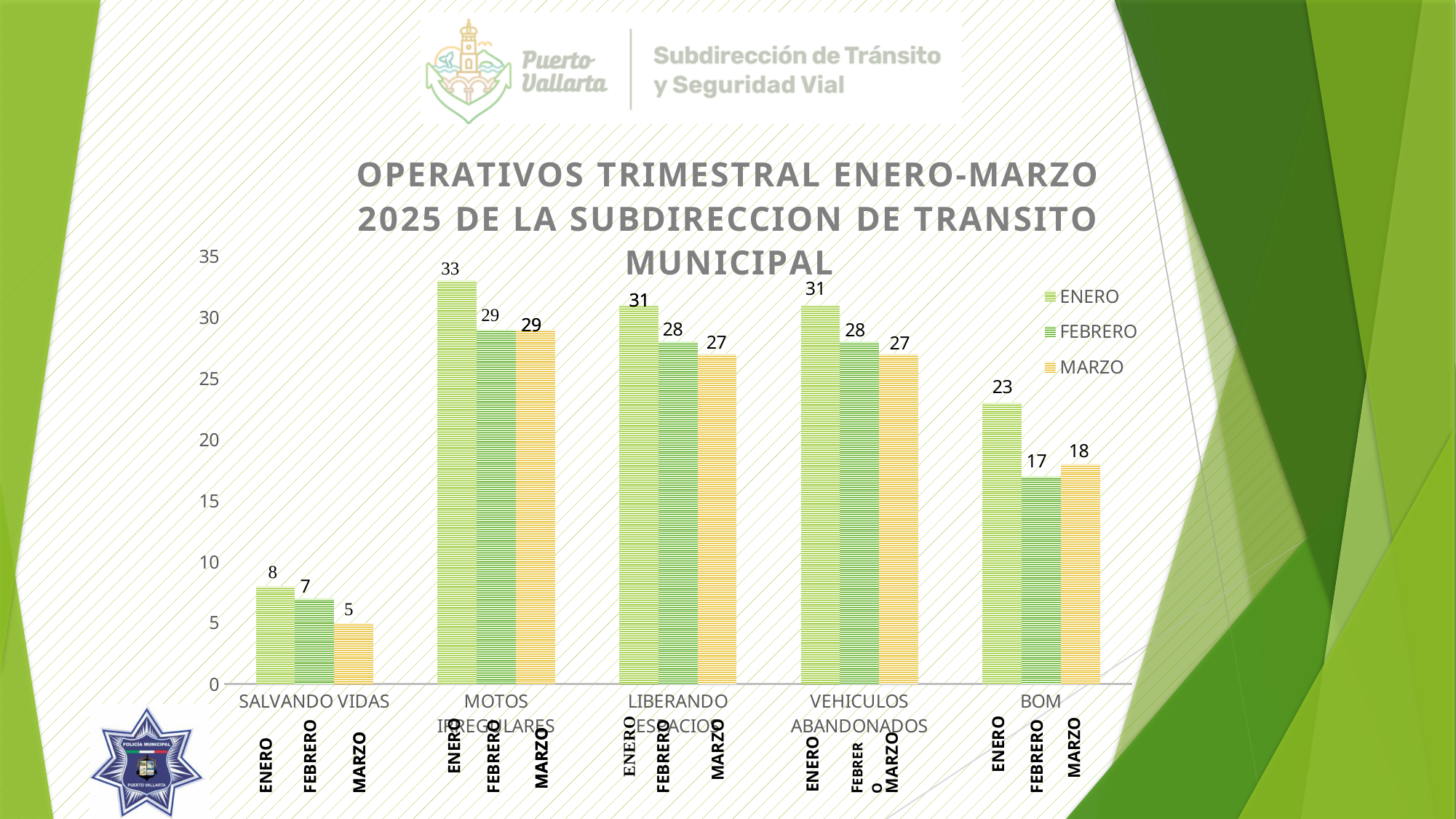
What is the difference between the ENERO and MARZO values for BOM? 5 How many series does the legend list? 3 How many categories are shown on the x axis? 5 Which series is shown in orange in the legend? MARZO Which category has the highest ENERO value? MOTOS IRREGULARES Which is larger for BOM, the FEBRERO value or the MARZO value? MARZO Which category has the lowest FEBRERO value? SALVANDO VIDAS What is the MARZO value for VEHICULOS ABANDONADOS? 27 What kind of chart is shown on the slide? Bar chart What is the FEBRERO value for BOM? 17 What is the ENERO value for MOTOS IRREGULARES? 33 What is the MARZO value for SALVANDO VIDAS? 5